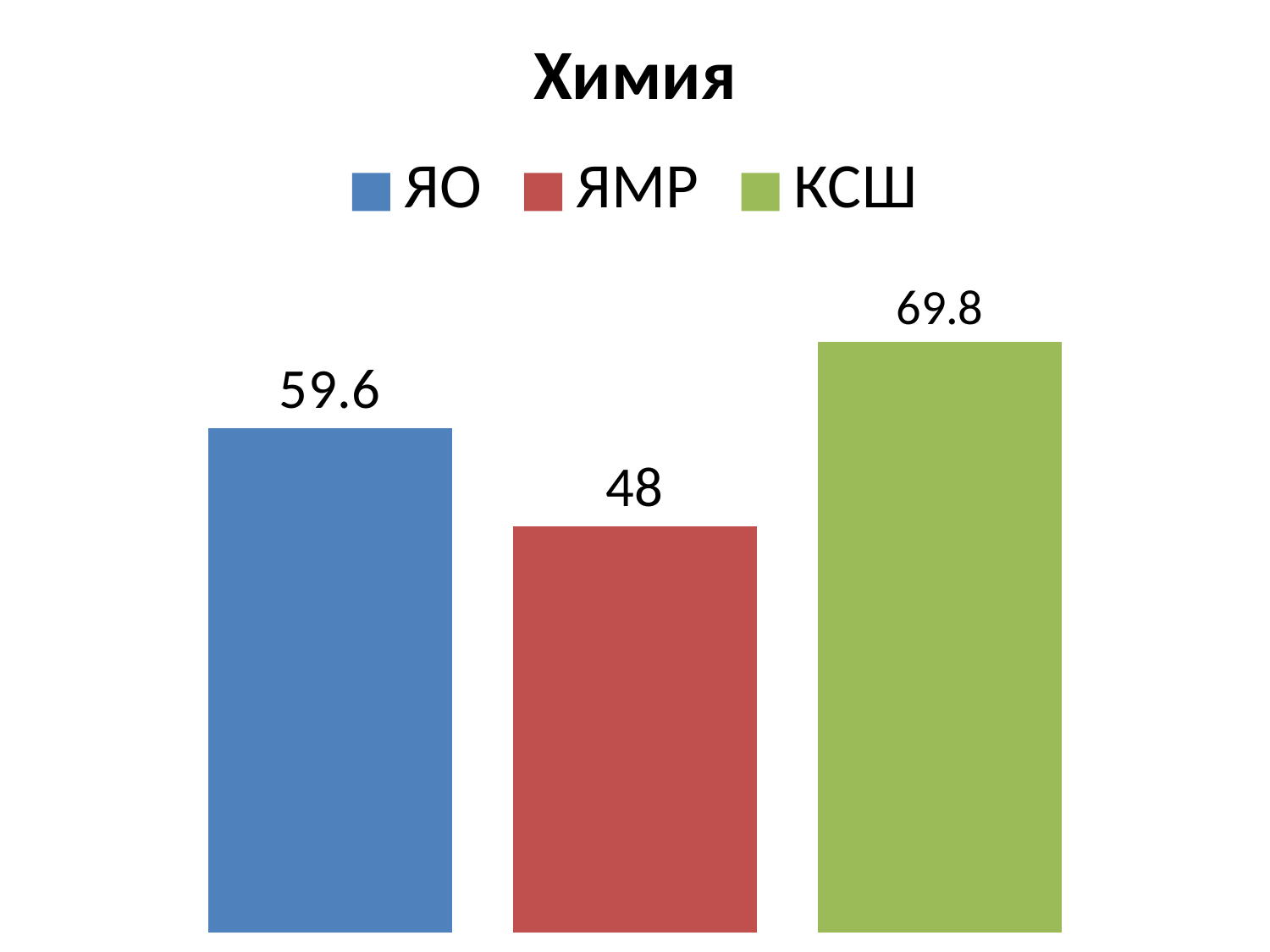
How many series does the legend list? 3 What is the difference between the values for КСШ and ЯО? 10.2 What is the title of the chart? Химия What is the value for КСШ? 69.8 How many bars are plotted on the chart? 3 What is the value for ЯО? 59.6 Which is larger, the value for ЯО or the value for ЯМР? ЯО What is the difference between the values for ЯО and ЯМР? 11.6 What is the value for ЯМР? 48 Which series has the lowest value? ЯМР What kind of chart is shown? bar chart Which series has the highest value? КСШ